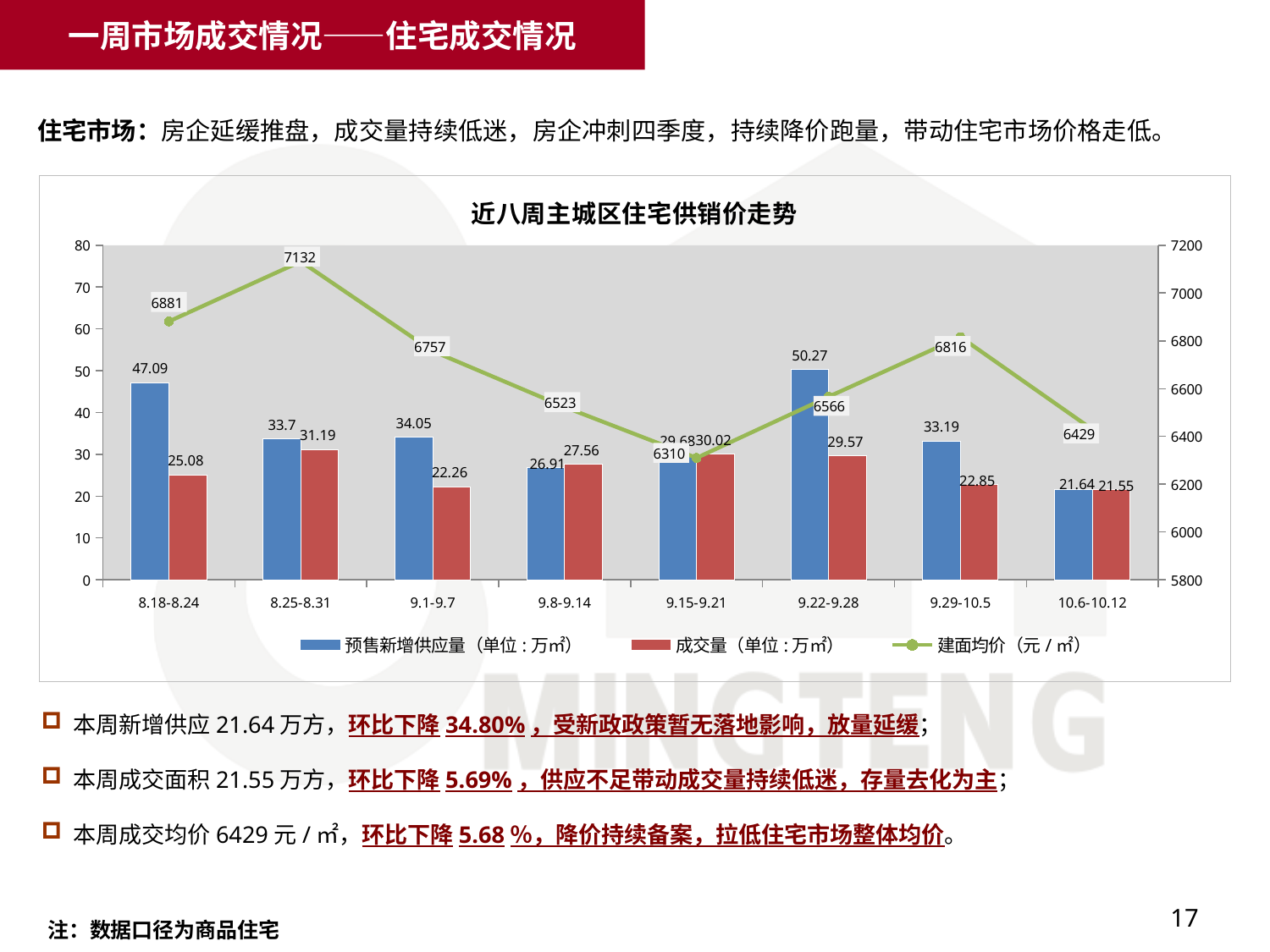
How many series does the chart legend list? 3 What is the 建面均价 value for the week 8.25-8.31? 7132 What is the 预售新增供应量 value for the week 8.18-8.24? 47.09 What is the 成交量 value for the week 9.8-9.14? 27.56 For the week 9.1-9.7, which is larger: 预售新增供应量 or 成交量? 预售新增供应量 What is the 成交量 value for the week 10.6-10.12? 21.55 What kind of chart is shown on the slide? Combination bar and line chart How many weeks are shown on the x axis of the chart? 8 Which week has the lowest 建面均价? 9.15-9.21 Which week has the highest 建面均价? 8.25-8.31 Which week has the highest 预售新增供应量? 9.22-9.28 For the week 9.22-9.28, what is the difference between 预售新增供应量 and 成交量? 20.7